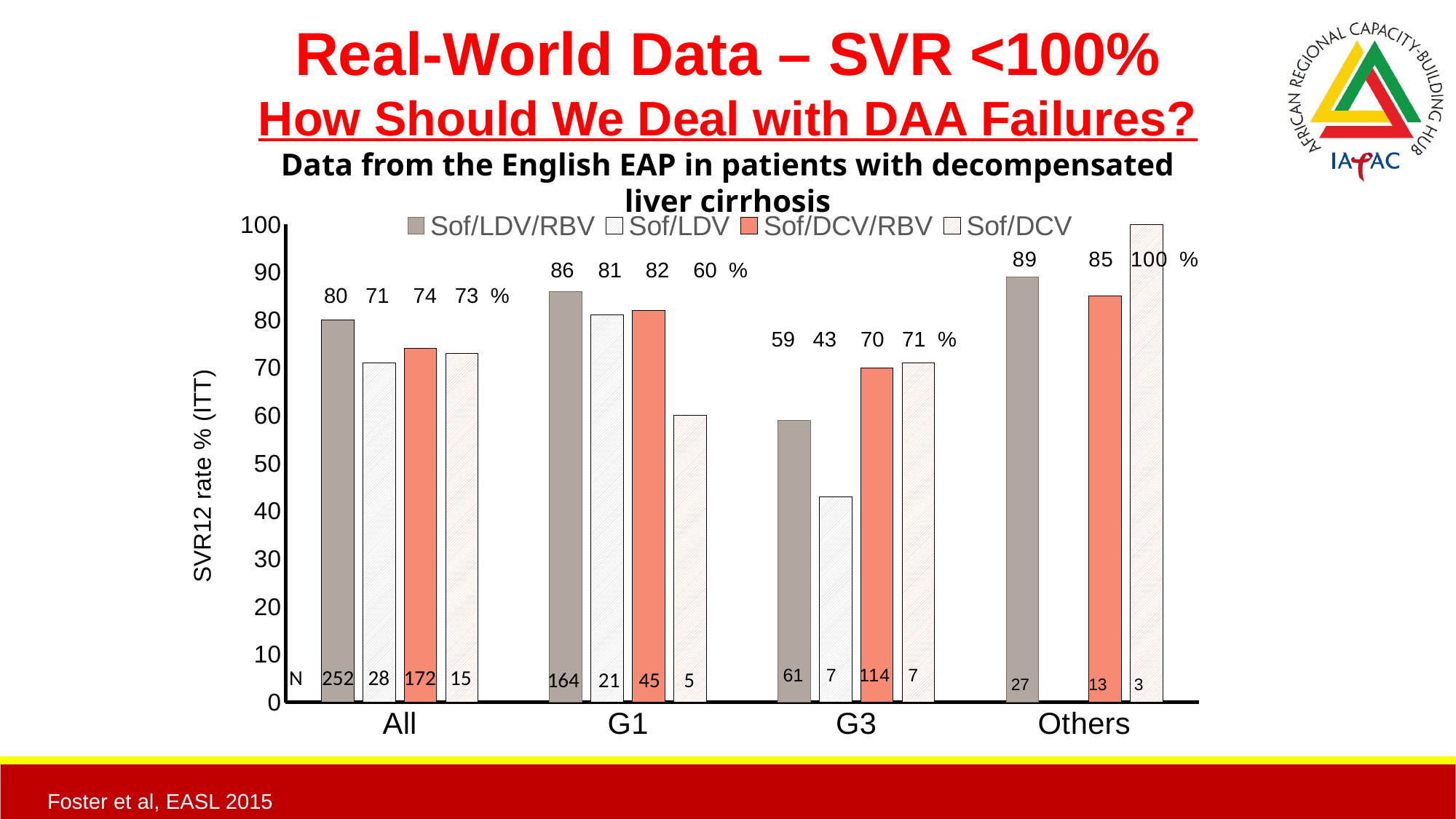
How many patient groups are shown on the x axis? 4 What is the SVR12 rate for Sof/DCV in the Others group? 100% What is the SVR12 rate for Sof/LDV in the G3 group? 43% How many regimens does the legend list? 4 In the G1 group, how many percentage points higher is the SVR12 rate for Sof/LDV/RBV than for Sof/DCV? 26 Which regimen has the highest SVR12 rate in the Others group? Sof/DCV What is the N (number of patients) for Sof/DCV/RBV in the All group? 172 In the All group, which has the higher SVR12 rate: Sof/DCV/RBV or Sof/LDV? Sof/DCV/RBV Which regimen has the lowest SVR12 rate in the G3 group? Sof/LDV What is the SVR12 rate for Sof/DCV in the G1 group? 60% What kind of chart is shown on the slide? Bar chart What is the SVR12 rate for Sof/LDV/RBV in the All group? 80%